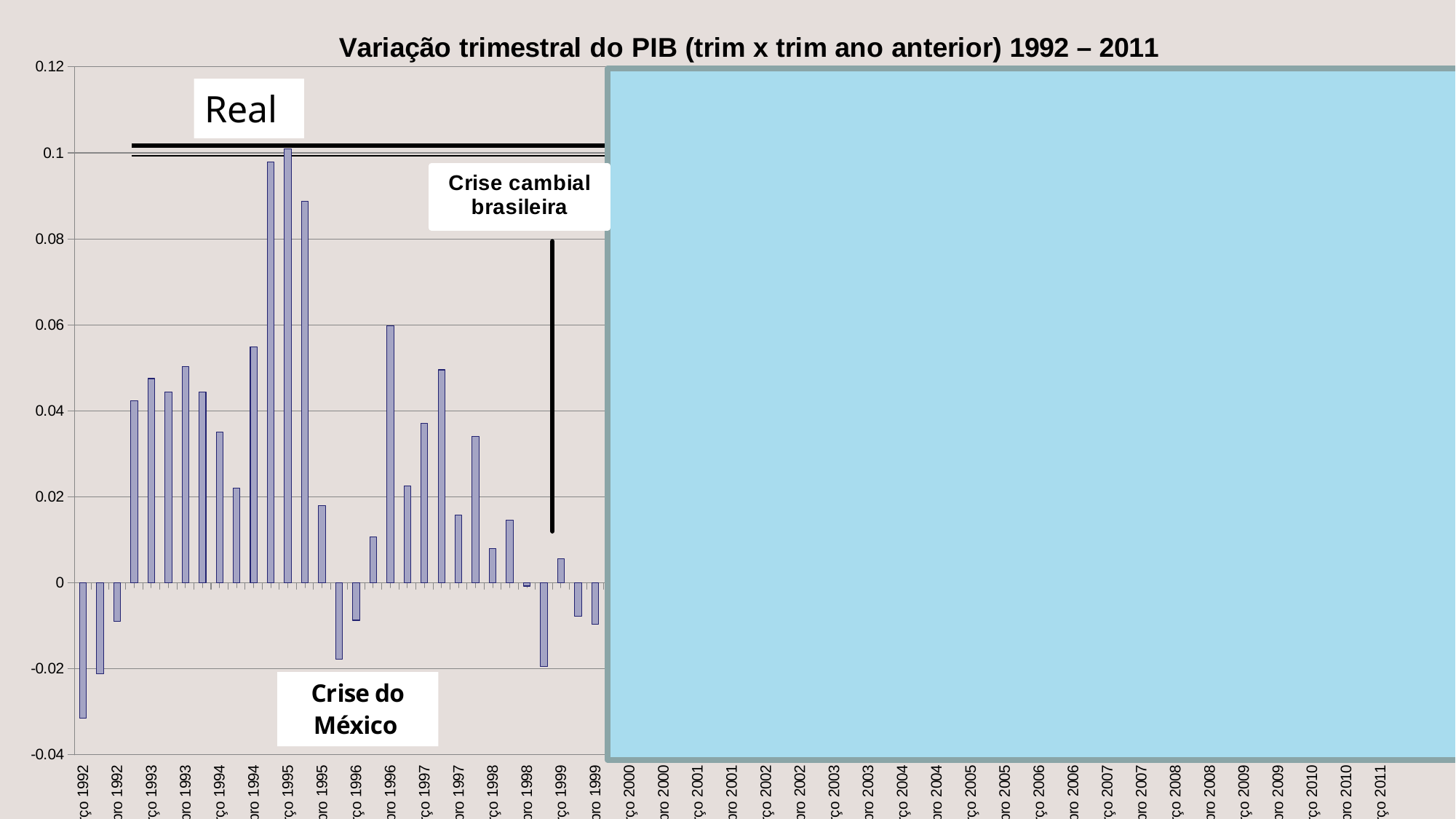
In which year does the tallest visible bar occur? 1995 Is the value of the tallest visible bar greater or less than 0.08? greater Is the value of the tallest bar in 1996 greater or less than 0.04? greater What is the title of the chart? Variação trimestral do PIB (trim x trim ano anterior) 1992 – 2011 Which is larger: the tallest bar in 1995 or the tallest bar in 1996? the tallest bar in 1995 What kind of chart is shown on the slide? bar chart Which is larger: the tallest bar in 1993 or the tallest bar in 1999? the tallest bar in 1993 Is the value of the leftmost bar (1992) greater or less than -0.02? less What is the highest value shown on the vertical axis? 0.12 In which year does the lowest (most negative) visible bar occur? 1992